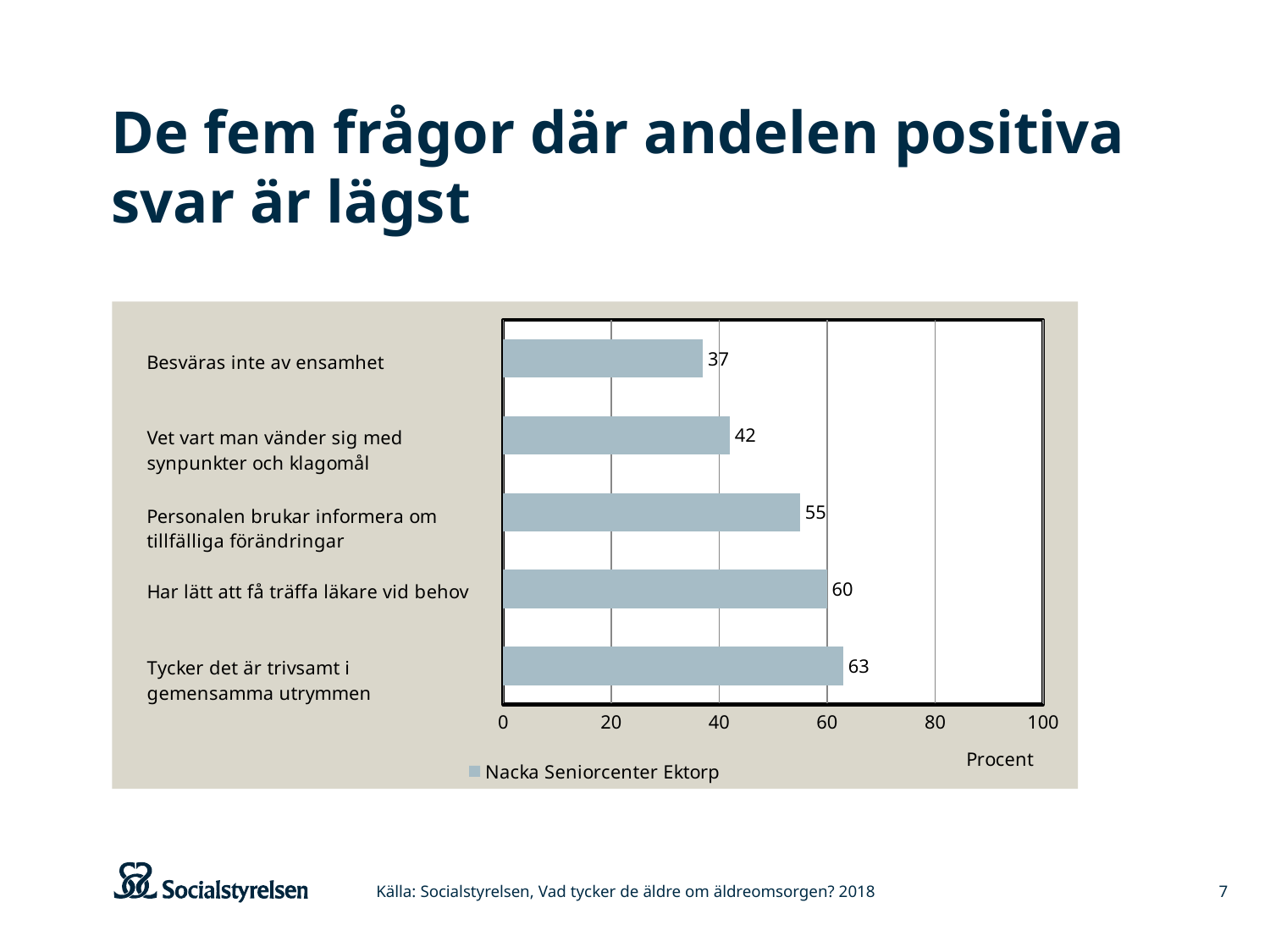
What is the difference between the values for "Tycker det är trivsamt i gemensamma utrymmen" and "Besväras inte av ensamhet"? 26 What kind of chart is shown on the slide? Bar chart Is the value for "Vet vart man vänder sig med synpunkter och klagomål" greater or less than 40? greater Which category has the lowest value? Besväras inte av ensamhet What is the value for "Personalen brukar informera om tillfälliga förändringar"? 55 What series name is shown in the legend? Nacka Seniorcenter Ektorp Which category has the highest value? Tycker det är trivsamt i gemensamma utrymmen Which is larger: the value for "Vet vart man vänder sig med synpunkter och klagomål" or the value for "Personalen brukar informera om tillfälliga förändringar"? Personalen brukar informera om tillfälliga förändringar What is the value for "Besväras inte av ensamhet"? 37 What is the value for "Har lätt att få träffa läkare vid behov"? 60 How many series does the legend list? 1 How many categories are shown in the chart? 5